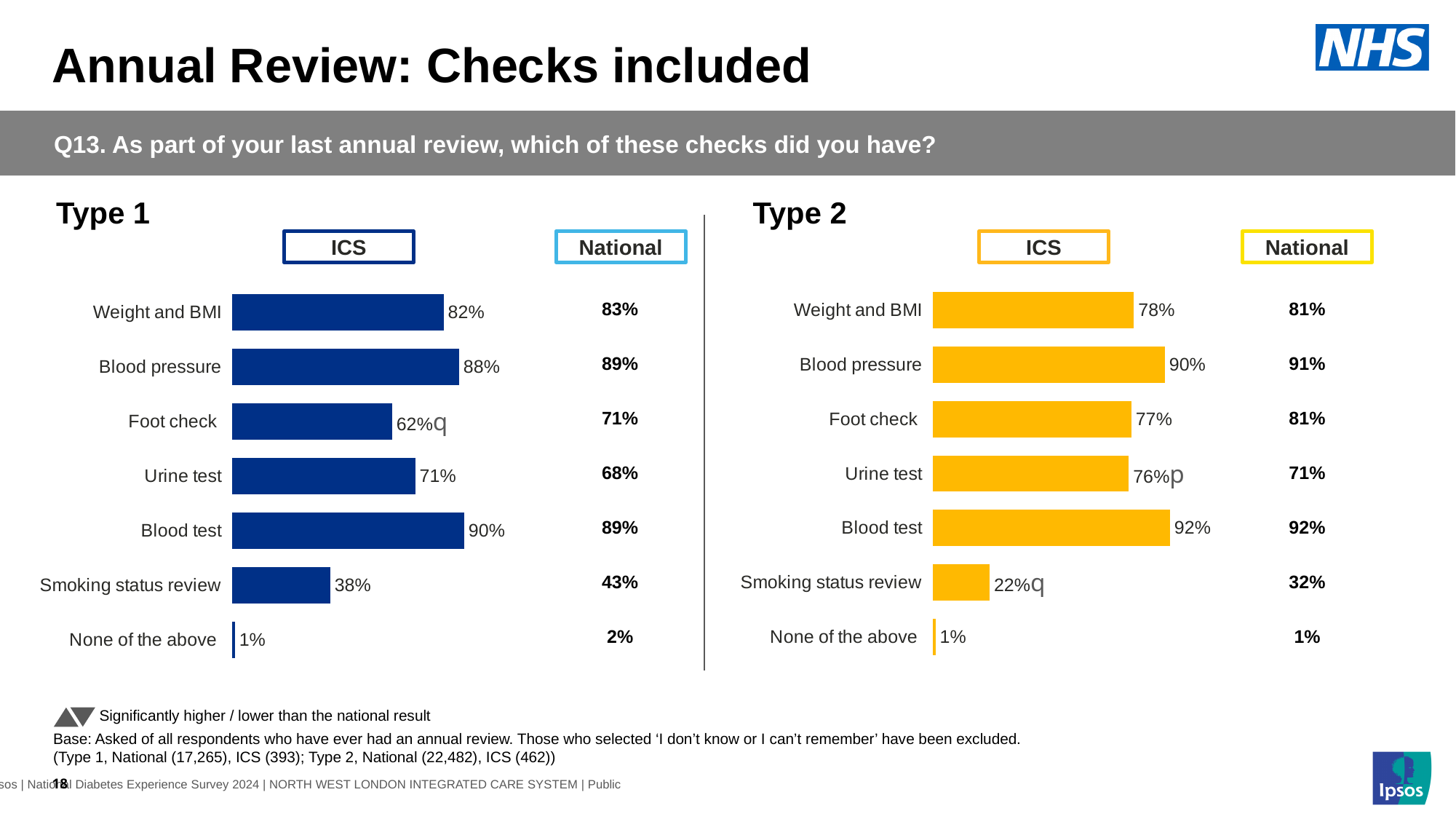
How many checks are listed in the Type 1 chart? 7 What type of chart is used for the Type 2 ICS results? Bar chart In the Type 2 chart, which check has the highest ICS value? Blood test In the Type 1 chart, what is the difference between the ICS and National values for Foot check? 9 percentage points In the Type 2 chart, what is the ICS value for Smoking status review? 22% What colour are the bars in the Type 2 chart? Yellow In the Type 1 chart, what is the National value for Urine test? 68% In the Type 1 chart, is the ICS value for Blood test or Blood pressure larger? Blood test In the Type 1 chart, which check has the lowest ICS value? None of the above In the Type 2 chart, what is the difference between the ICS values for Blood pressure and Weight and BMI? 12 percentage points In the Type 2 chart, is the ICS value for Smoking status review higher or lower than the National value? Higher In the Type 1 chart, what is the ICS value for Foot check? 62%